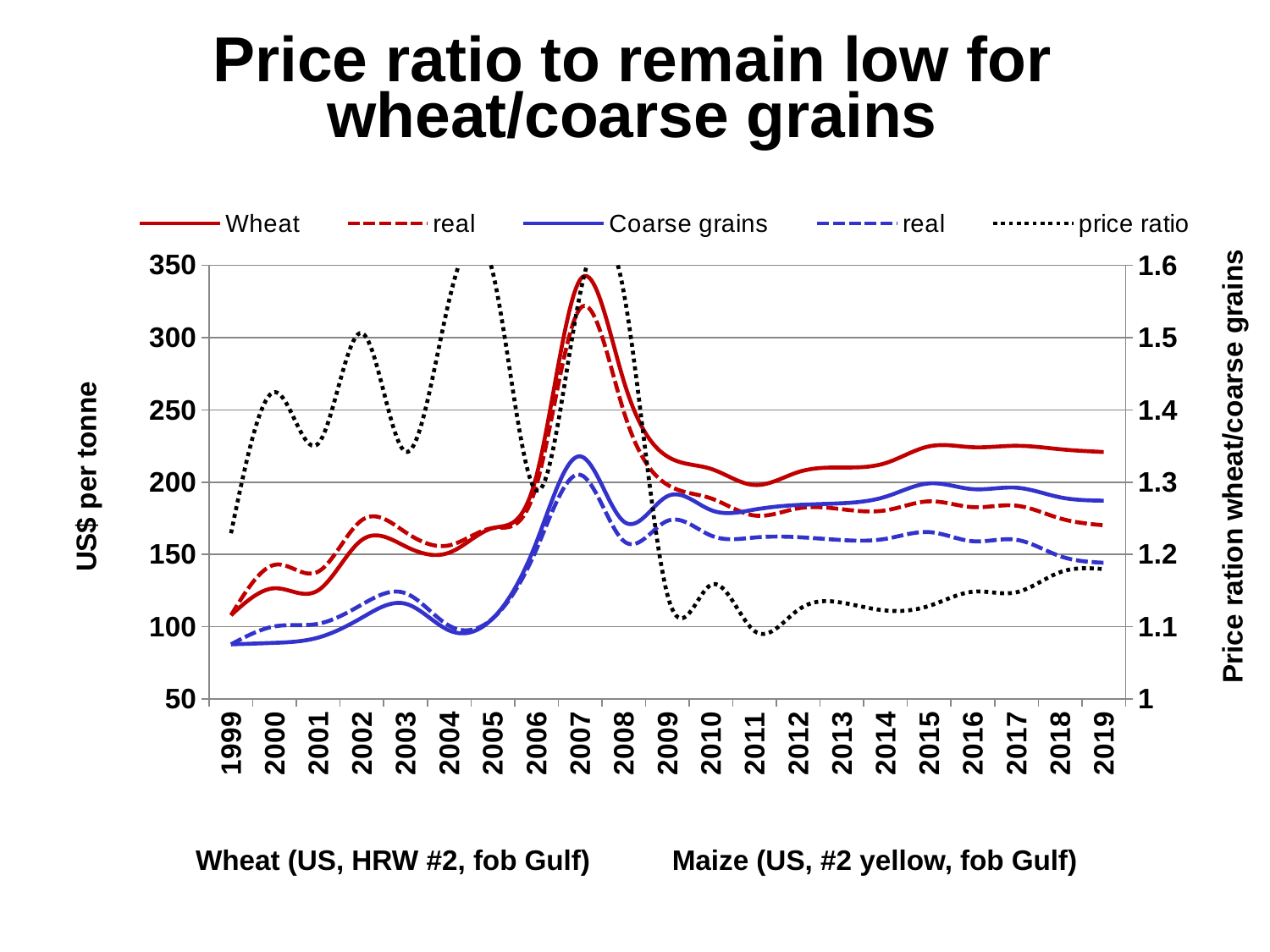
Which is larger in 2007, the Wheat value or the Coarse grains value? Wheat How many years are labelled on the x axis? 21 How many series does the legend list? 5 What is the title of the left vertical axis? US$ per tonne Is the value for Coarse grains in 2007 greater or less than 200? greater Is the value for Wheat in 2007 greater or less than 300? greater Does the Wheat series rise or fall between 2007 and 2011? fall In which year does the Wheat series reach its highest value? 2007 Is the value for Coarse grains in 1999 greater or less than 100? less What kind of chart is shown on the slide? line chart In which year is the Wheat series at its lowest value? 1999